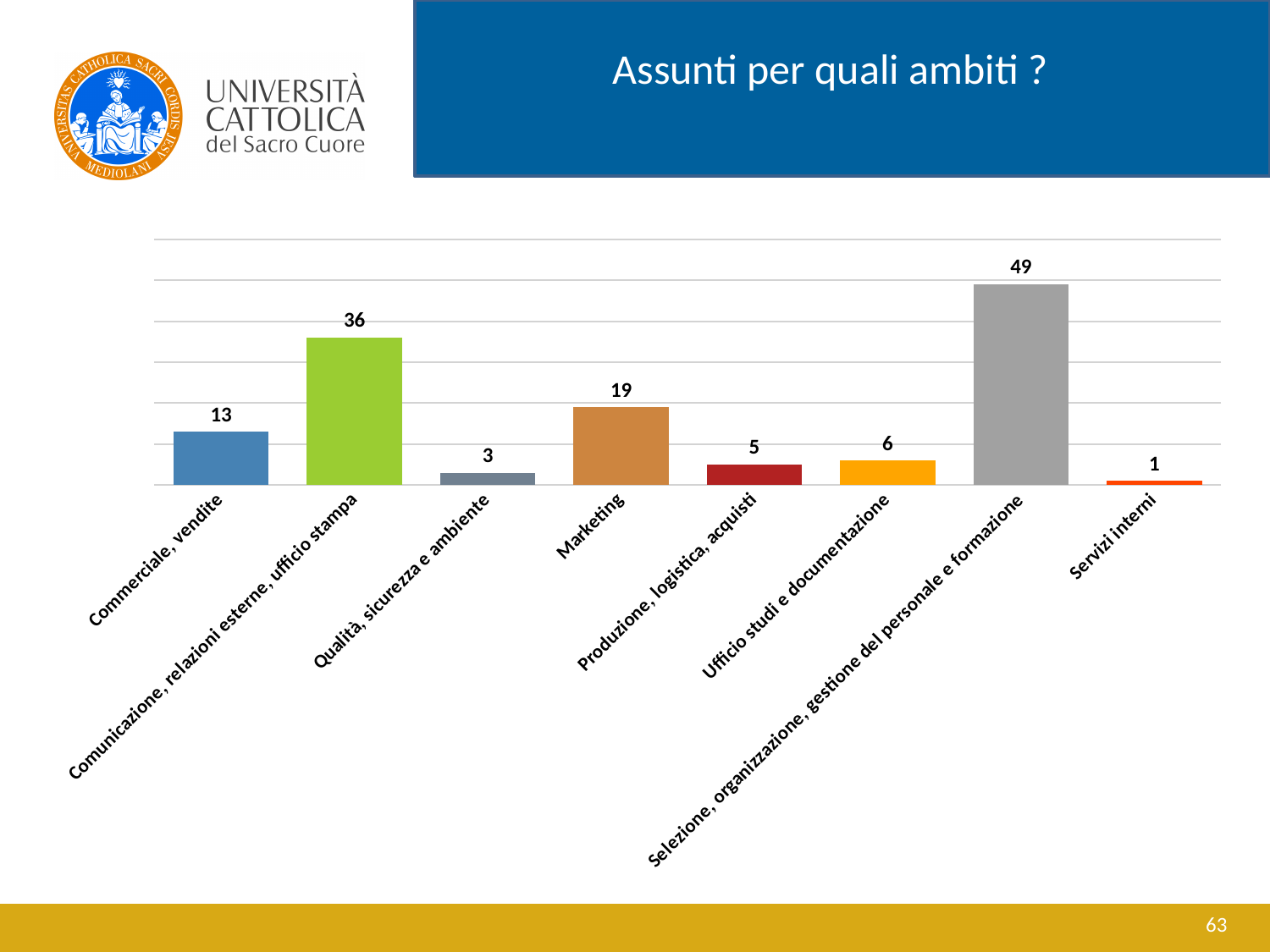
What kind of chart is shown on the slide? Bar chart Which category has the highest value? Selezione, organizzazione, gestione del personale e formazione Which category has the lowest value? Servizi interni Which is larger, the value for Commerciale, vendite or the value for Marketing? Marketing What is the value for Marketing? 19 What is the value for Comunicazione, relazioni esterne, ufficio stampa? 36 Which is larger, the value for Produzione, logistica, acquisti or the value for Ufficio studi e documentazione? Ufficio studi e documentazione What is the difference between the values for Commerciale, vendite and Qualità, sicurezza e ambiente? 10 What is the value for Servizi interni? 1 How many categories are shown in the chart? 8 What is the difference between the values for Selezione, organizzazione, gestione del personale e formazione and Comunicazione, relazioni esterne, ufficio stampa? 13 What is the title of the slide containing the chart? Assunti per quali ambiti ?